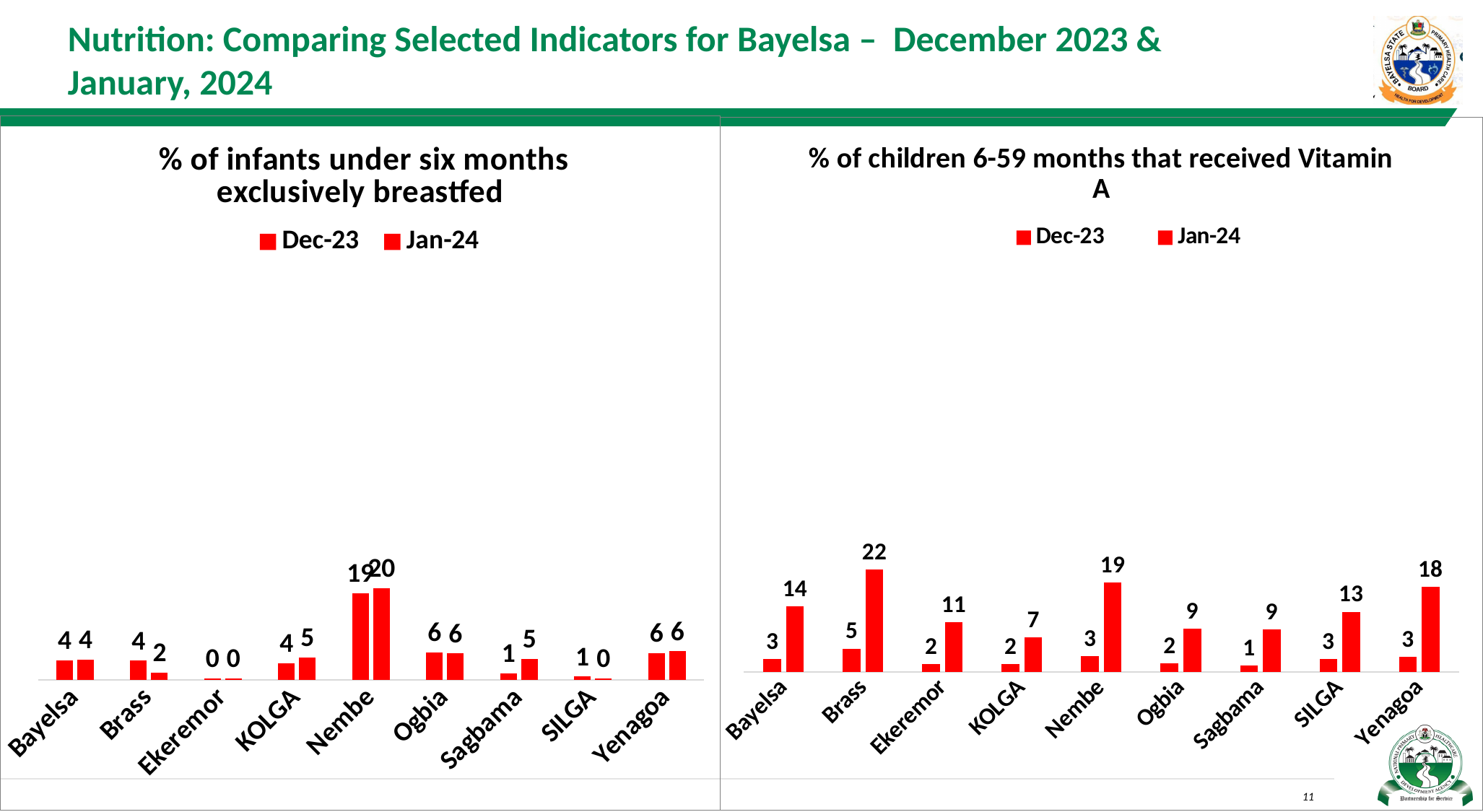
In the '% of children 6-59 months that received Vitamin A' chart, which is larger: the Jan-24 value for Nembe or the Jan-24 value for Yenagoa? Nembe How many series does the legend of the '% of children 6-59 months that received Vitamin A' chart list? 2 In the '% of infants under six months exclusively breastfed' chart, how many LGAs are shown on the x axis? 9 In the '% of infants under six months exclusively breastfed' chart, what is the Jan-24 value for Nembe? 20 In the '% of children 6-59 months that received Vitamin A' chart, what is the Jan-24 value for Brass? 22 In the '% of children 6-59 months that received Vitamin A' chart, what is the Dec-23 value for Yenagoa? 3 In the '% of children 6-59 months that received Vitamin A' chart, which LGA has the lowest Dec-23 value? Sagbama In the '% of children 6-59 months that received Vitamin A' chart, what is the difference between the Jan-24 and Dec-23 values for Bayelsa? 11 In the '% of infants under six months exclusively breastfed' chart, what is the Dec-23 value for Sagbama? 1 In the '% of infants under six months exclusively breastfed' chart, which LGA has the highest Jan-24 value? Nembe What type of chart is the '% of infants under six months exclusively breastfed' chart? Bar chart In the '% of infants under six months exclusively breastfed' chart, what is the difference between the Jan-24 and Dec-23 values for Sagbama? 4